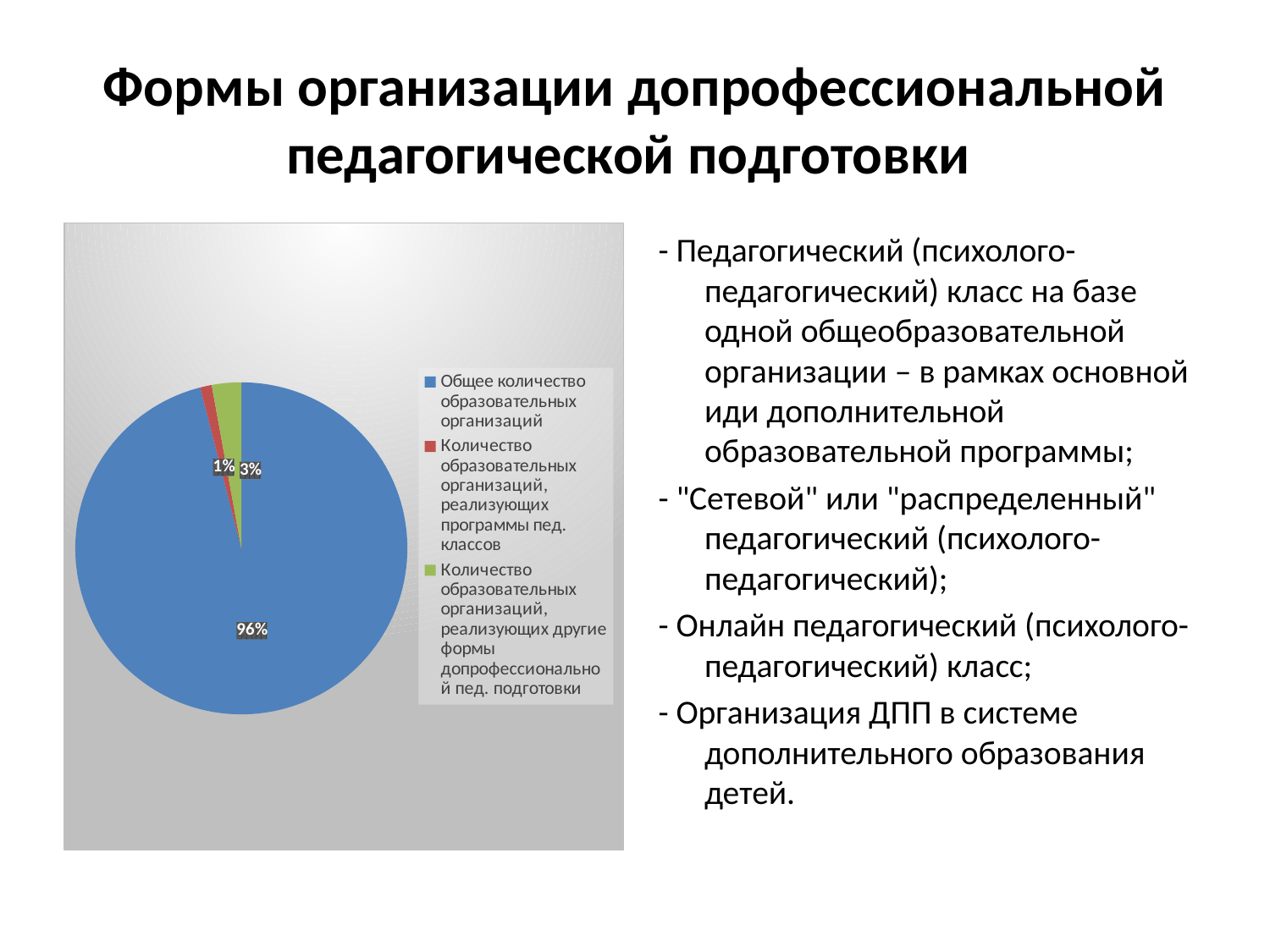
What share of the pie does "Количество образовательных организаций, реализующих другие формы допрофессиональной пед. подготовки" take? 3% Which slice of the pie chart is the smallest? Количество образовательных организаций, реализующих программы пед. классов Which is larger: the slice for organisations implementing pedagogical class programmes or the slice for organisations implementing other forms of pre-professional pedagogical training? Other forms of pre-professional pedagogical training (3%) What is the difference in percentage points between the largest slice (96%) and the 3% slice? 93 What share of the pie does "Общее количество образовательных организаций" take? 96% What colour is the slice labelled 96%? Blue What share of the pie does "Количество образовательных организаций, реализующих программы пед. классов" take? 1% How many entries does the legend of the pie chart list? 3 How many slices does the pie chart have? 3 Which slice of the pie chart is the largest? Общее количество образовательных организаций What colour is the slice for "Количество образовательных организаций, реализующих программы пед. классов"? Red What kind of chart is shown on the slide? Pie chart